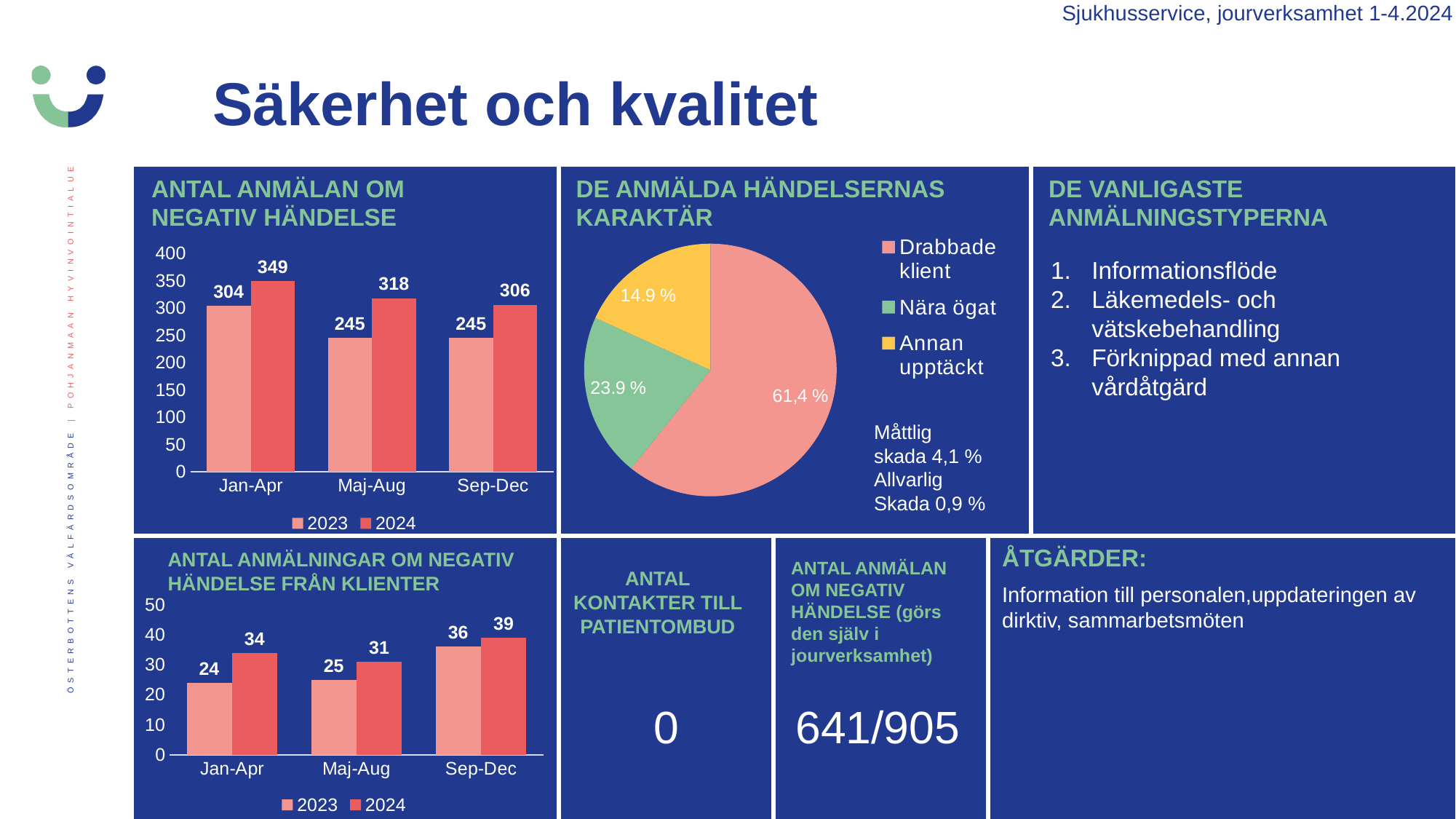
In the chart 'ANTAL ANMÄLNINGAR OM NEGATIV HÄNDELSE FRÅN KLIENTER', do the 2024 values rise or fall from Jan-Apr to Sep-Dec? Fall then rise In the pie chart 'DE ANMÄLDA HÄNDELSERNAS KARAKTÄR', what share is 'Annan upptäckt'? 14.9 % In the chart 'ANTAL ANMÄLAN OM NEGATIV HÄNDELSE', which period has the highest 2024 value? Jan-Apr In the chart 'ANTAL ANMÄLNINGAR OM NEGATIV HÄNDELSE FRÅN KLIENTER', which period has the lowest 2023 value? Jan-Apr In the chart 'ANTAL ANMÄLNINGAR OM NEGATIV HÄNDELSE FRÅN KLIENTER', what is the value for 2024 in Sep-Dec? 39 In the pie chart 'DE ANMÄLDA HÄNDELSERNAS KARAKTÄR', which category has the largest slice? Drabbade klient In the chart 'ANTAL ANMÄLAN OM NEGATIV HÄNDELSE', what is the value for 2023 in Maj-Aug? 245 In the chart 'ANTAL ANMÄLAN OM NEGATIV HÄNDELSE', what is the difference between the 2024 and 2023 values for Sep-Dec? 61 In the chart 'ANTAL ANMÄLAN OM NEGATIV HÄNDELSE', what is the value for 2024 in Jan-Apr? 349 In the chart 'ANTAL ANMÄLAN OM NEGATIV HÄNDELSE', how many series does the legend list? 2 What kind of chart is 'DE ANMÄLDA HÄNDELSERNAS KARAKTÄR'? Pie chart In the pie chart 'DE ANMÄLDA HÄNDELSERNAS KARAKTÄR', what share is 'Nära ögat'? 23.9 %